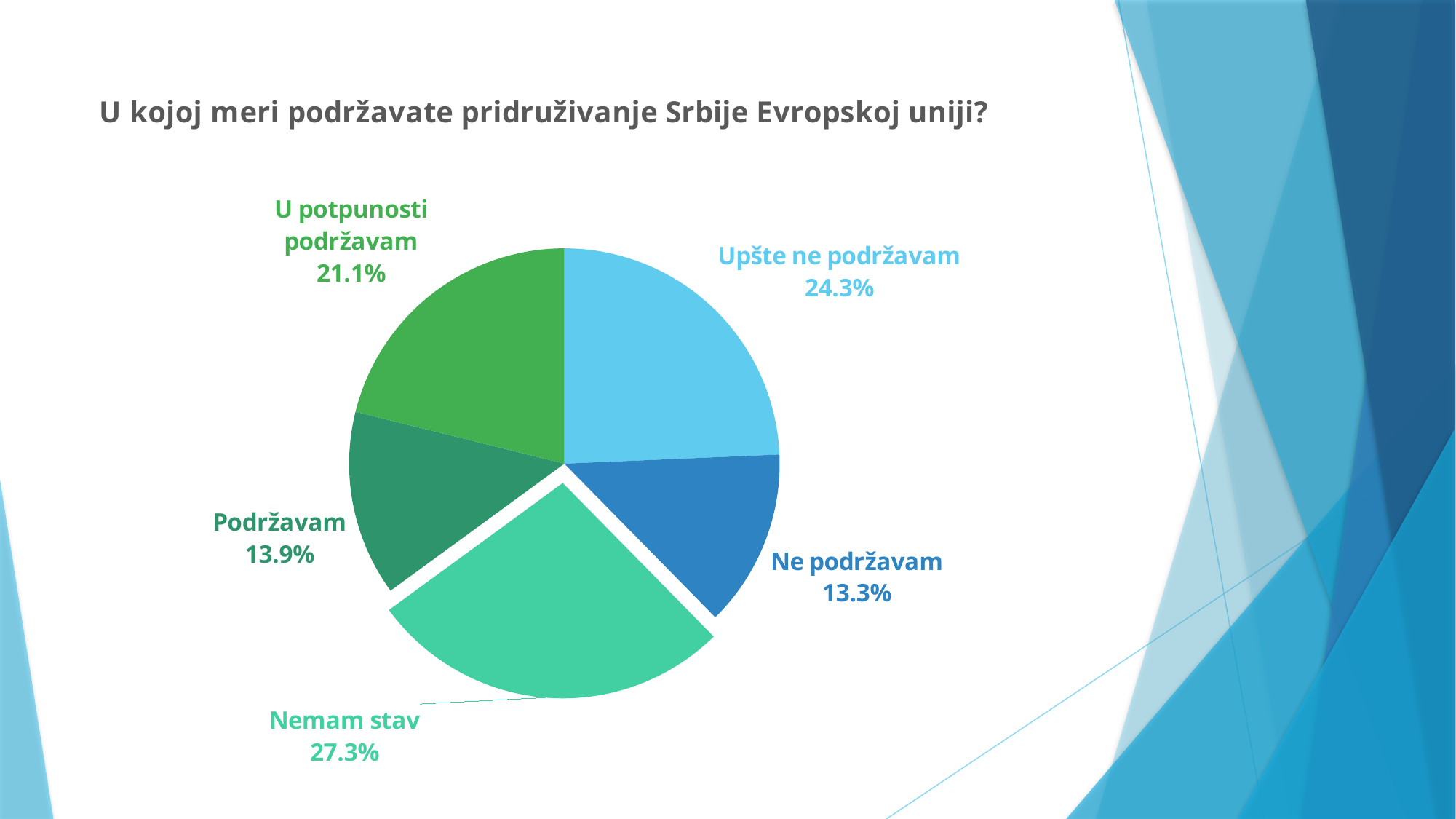
What kind of chart is shown on the slide? pie chart What is the difference between the shares for "Nemam stav" and "Upšte ne podržavam"? 3.0 percentage points What is the value for "U potpunosti podržavam"? 21.1% What percentage of respondents answered "Nemam stav"? 27.3% Which is larger, the share for "U potpunosti podržavam" or the share for "Upšte ne podržavam"? Upšte ne podržavam What is the combined share of "U potpunosti podržavam" and "Podržavam"? 35.0% Which category has the largest share of the pie? Nemam stav What is the value for "Upšte ne podržavam"? 24.3% How many slices does the pie chart have? 5 What question is shown as the title of the chart? U kojoj meri podržavate pridruživanje Srbije Evropskoj uniji? What is the value for "Podržavam"? 13.9% Which category has the smallest share of the pie? Ne podržavam